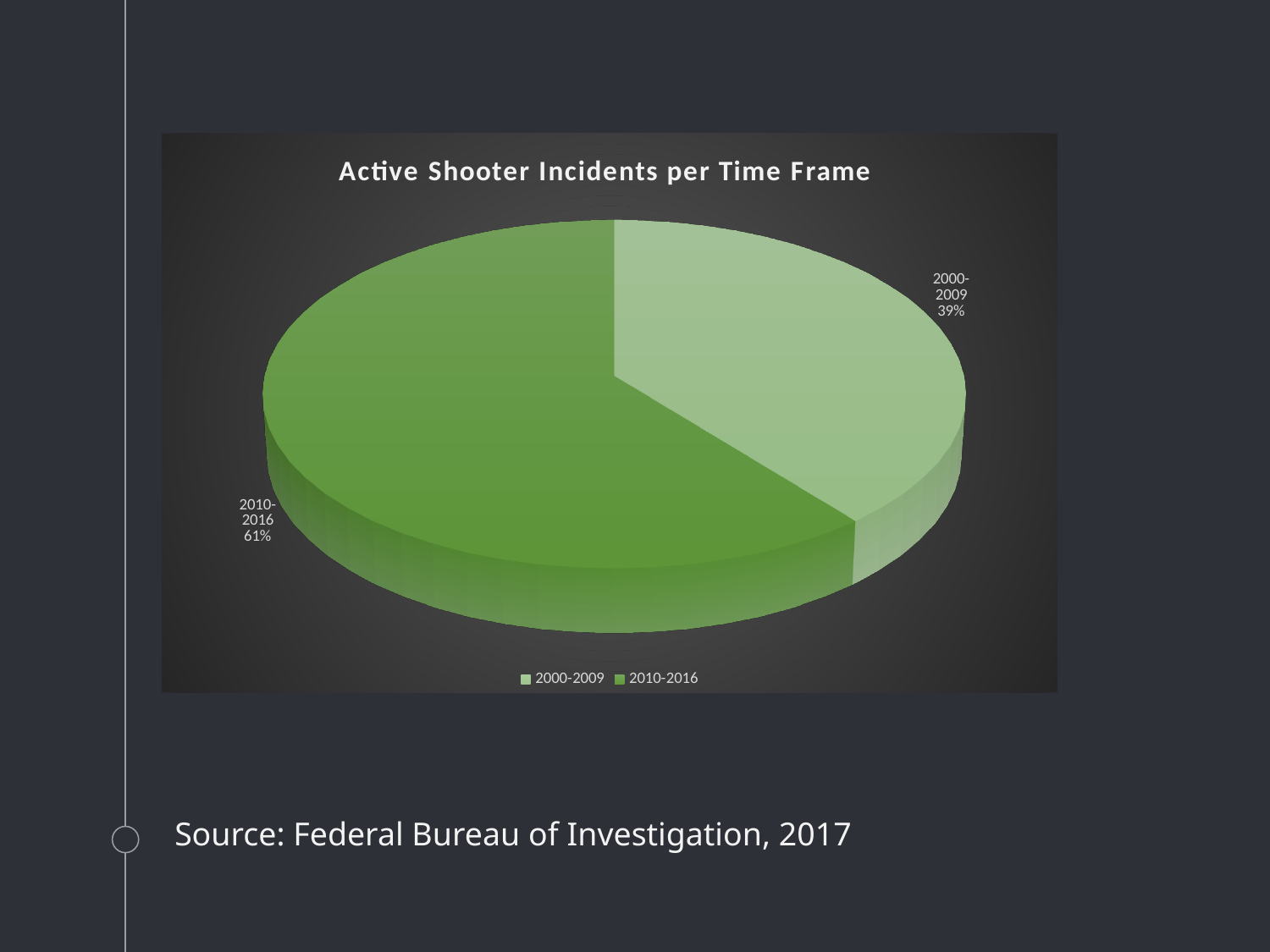
How many slices does the pie chart have? 2 Which slice is larger, 2000-2009 or 2010-2016? 2010-2016 Which time frame is shown in the darker green slice? 2010-2016 Which time frame has the smallest share of active shooter incidents? 2000-2009 What is the difference in percentage points between the 2010-2016 share and the 2000-2009 share? 22 percentage points What is the title of the chart? Active Shooter Incidents per Time Frame What share of the pie does the 2000-2009 slice represent? 39% Which time frame has the largest share of active shooter incidents? 2010-2016 What share of the pie does the 2010-2016 slice represent? 61% How many entries does the legend list? 2 What kind of chart is shown on the slide? Pie chart